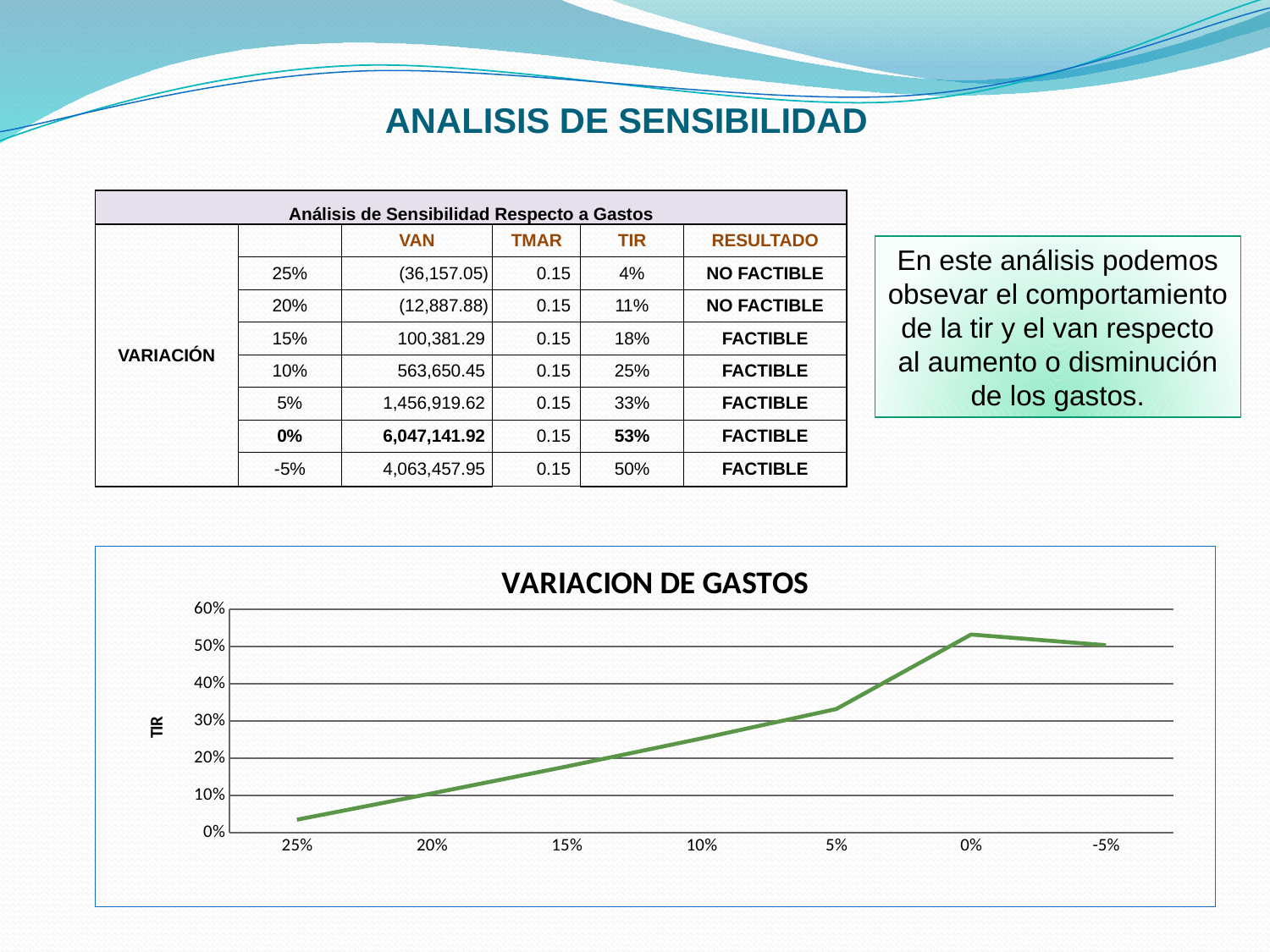
How many variation categories are plotted along the x axis of the VARIACION DE GASTOS chart? 7 In the VARIACION DE GASTOS chart, which has the higher TIR: the 5% variation or the 10% variation? 5% What kind of chart is shown under the title VARIACION DE GASTOS? line chart In the VARIACION DE GASTOS chart, is the TIR at a 20% variation greater or less than 20%? less In the VARIACION DE GASTOS chart, is the TIR at a 5% variation greater or less than 40%? less In the VARIACION DE GASTOS chart, at which variation level is the TIR lowest? 25% In the VARIACION DE GASTOS chart, at which variation level is the TIR highest? 0% In the VARIACION DE GASTOS chart, is the TIR at a 10% variation greater or less than 20%? greater According to the slide, what is the difference between the TIR at 0% variation and the TIR at 25% variation? 49% According to the slide, what is the TIR at a 0% variation in gastos? 53% In the VARIACION DE GASTOS chart, does the TIR rise or fall as the variation goes from 25% to 0%? rises What is the label on the vertical axis of the VARIACION DE GASTOS chart? TIR